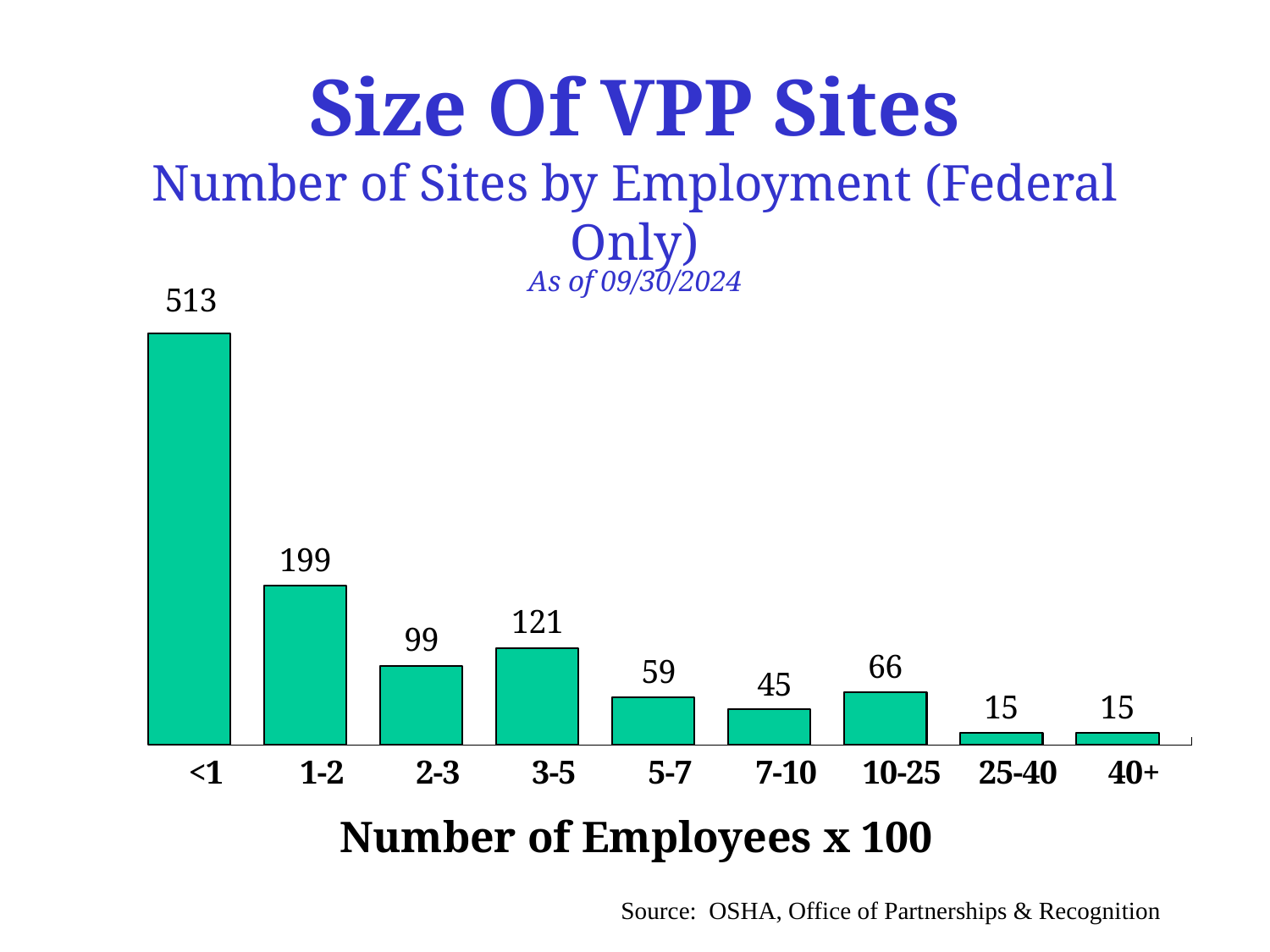
What is the value for the 10-25 category? 66 Which category has the highest number of sites? <1 What is the difference between the values for <1 and 1-2? 314 What is the value for the 3-5 category? 121 What is the lowest value shown on the chart? 15 Which is larger, the value for 5-7 or the value for 7-10? 5-7 What is the x-axis title of the chart? Number of Employees x 100 What is the difference between the values for 3-5 and 2-3? 22 What date is the chart data as of? 09/30/2024 What kind of chart is shown on the slide? bar chart How many sites are in the <1 category? 513 How many categories are shown on the x axis? 9